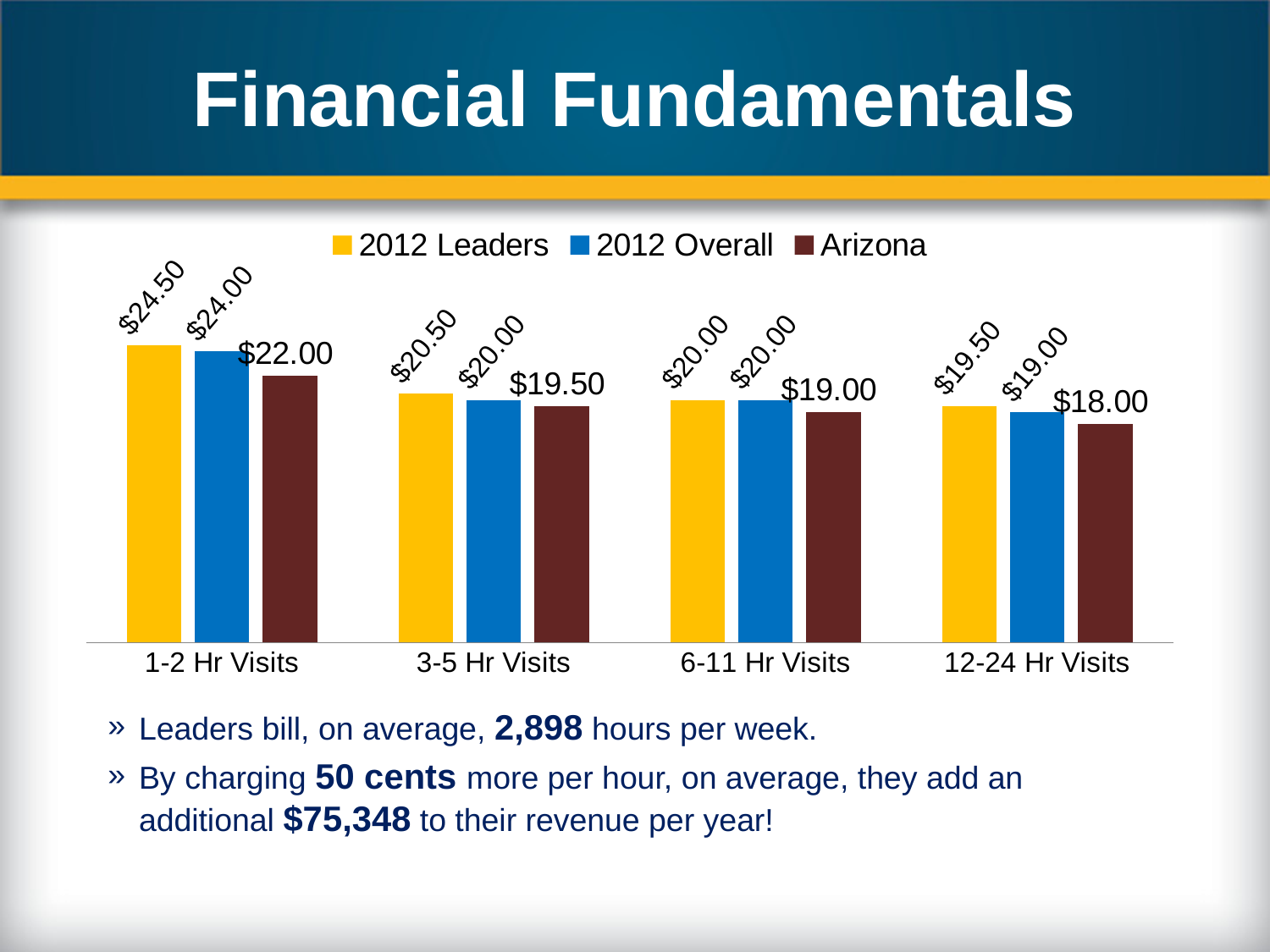
Which visit category has the highest value for Arizona? 1-2 Hr Visits Which visit category has the lowest value for 2012 Leaders? 12-24 Hr Visits What is the difference between 2012 Leaders and 2012 Overall for 12-24 Hr Visits? $0.50 What is the value for 2012 Overall for 3-5 Hr Visits? $20.00 How many visit categories are shown on the x axis? 4 Which is larger for 6-11 Hr Visits: 2012 Overall or Arizona? 2012 Overall What is the value for 2012 Leaders for 1-2 Hr Visits? $24.50 What is the value for Arizona for 12-24 Hr Visits? $18.00 How many series does the legend list? 3 Do the 2012 Leaders values rise or fall from 1-2 Hr Visits to 12-24 Hr Visits? Fall What is the difference between 2012 Leaders and Arizona for 1-2 Hr Visits? $2.50 What kind of chart is shown on the slide? Bar chart